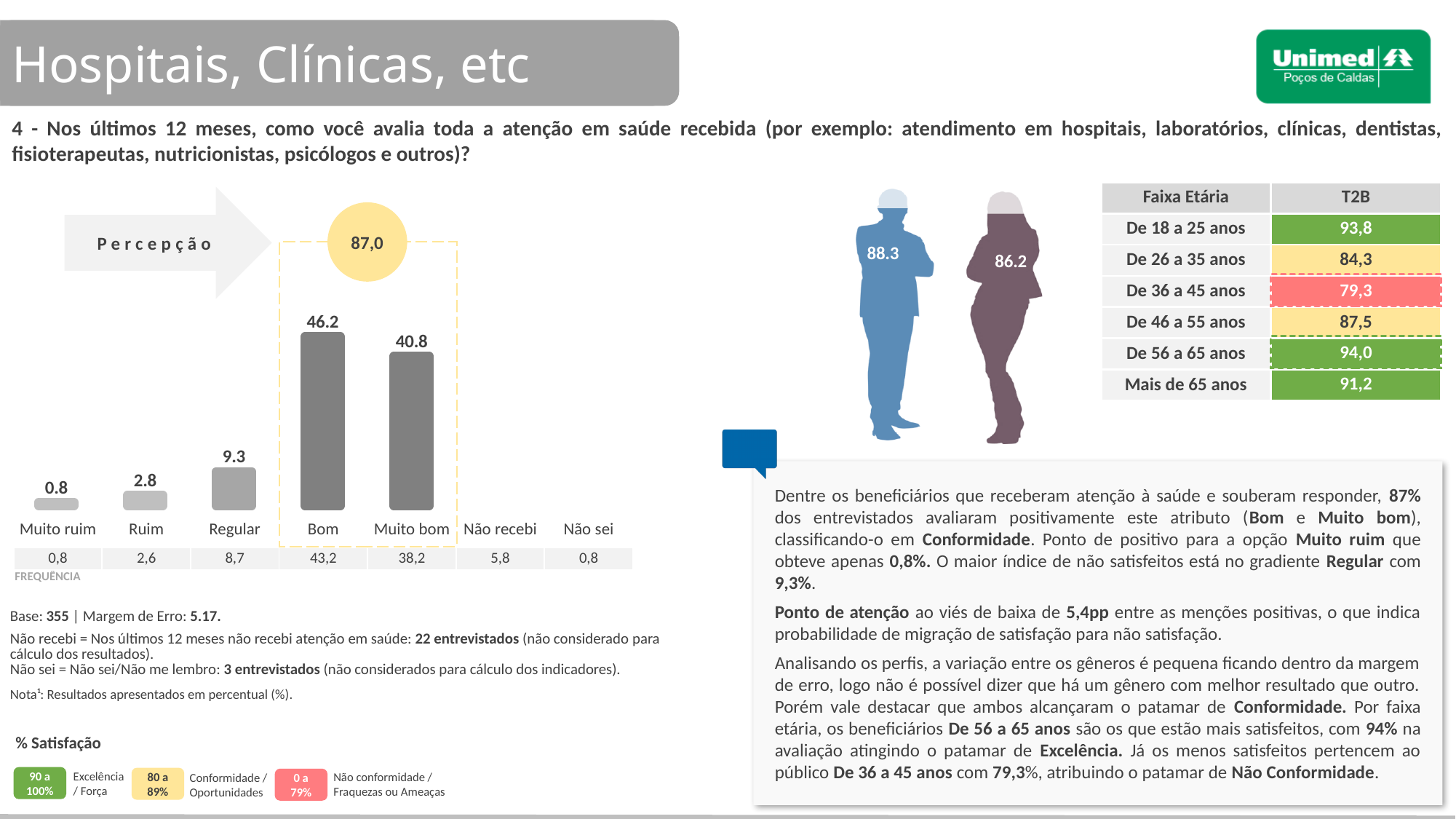
What is the combined value of the 'Bom' and 'Muito bom' bars, as shown in the circle above them? 87,0 What type of chart is shown on the slide? Bar chart Which category has the highest bar in the chart? Bom What value is shown for the 'Muito ruim' bar in the chart? 0.8 What is the frequency value shown below the chart for 'Não recebi'? 5,8 Which is larger in the chart, the value for 'Ruim' or the value for 'Regular'? Regular What value is shown for the 'Bom' bar in the chart? 46.2 What value is shown for the 'Muito bom' bar in the chart? 40.8 What value is shown for the 'Regular' bar in the chart? 9.3 What label appears in the arrow to the left of the chart? Percepção Which category has the lowest bar among the plotted bars in the chart? Muito ruim What is the difference between the 'Bom' and 'Muito bom' values in the chart? 5.4